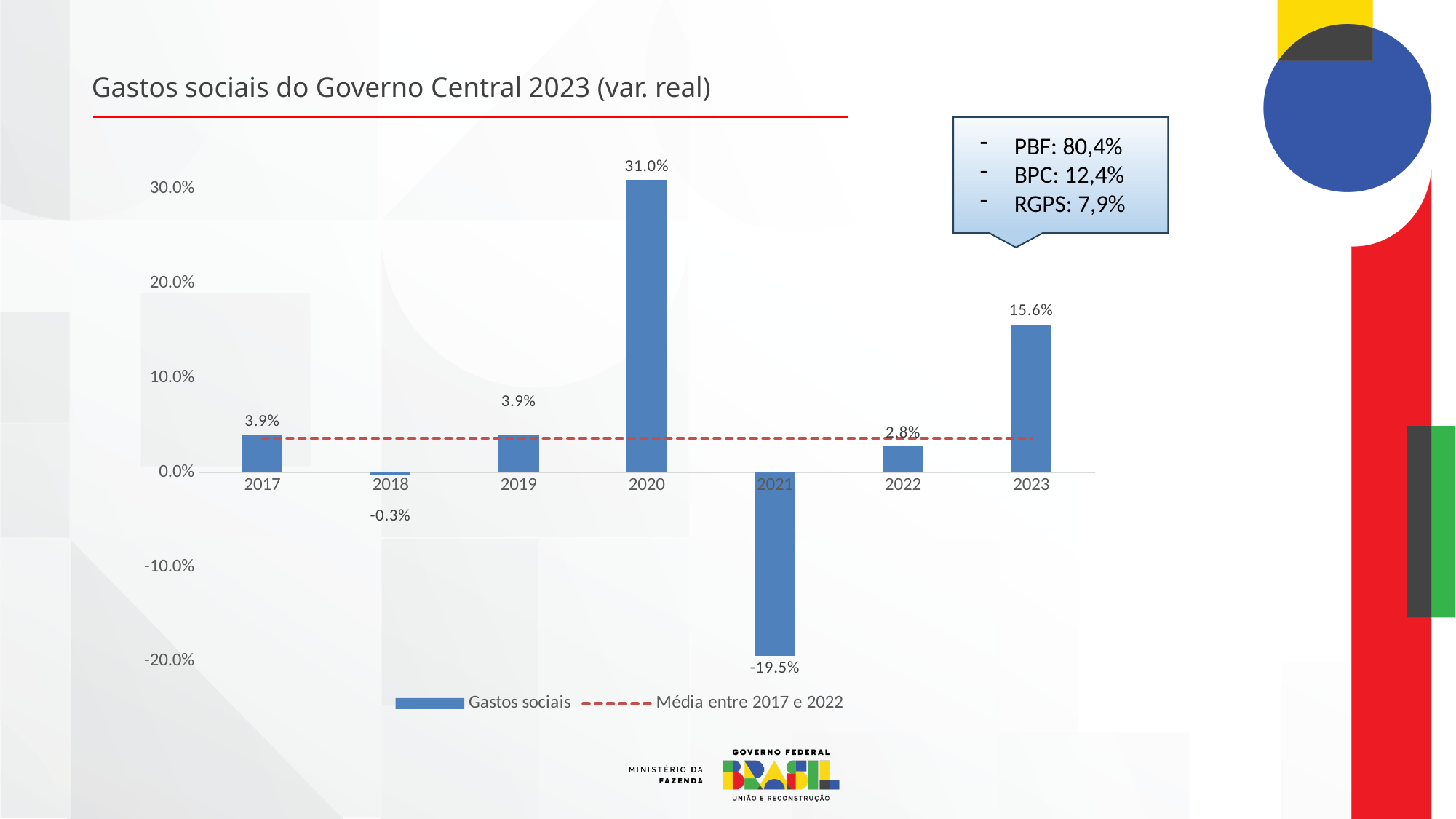
How many series does the chart legend list? 2 What is the value for 2021 in the Gastos sociais chart? -19.5% Which is larger, the Gastos sociais value for 2022 or for 2023? 2023 What is the value for 2020 in the Gastos sociais chart? 31.0% Which year has the lowest value for Gastos sociais? 2021 What is the title of the chart on the slide? Gastos sociais do Governo Central 2023 (var. real) What is the difference between the Gastos sociais values for 2020 and 2023? 15.4% What is the value for 2023 in the Gastos sociais chart? 15.6% Which year has the highest value for Gastos sociais? 2020 How many years are shown on the x axis of the chart? 7 Is the value of the Média entre 2017 e 2022 line greater or less than 10.0%? less What is the value for 2018 in the Gastos sociais chart? -0.3%